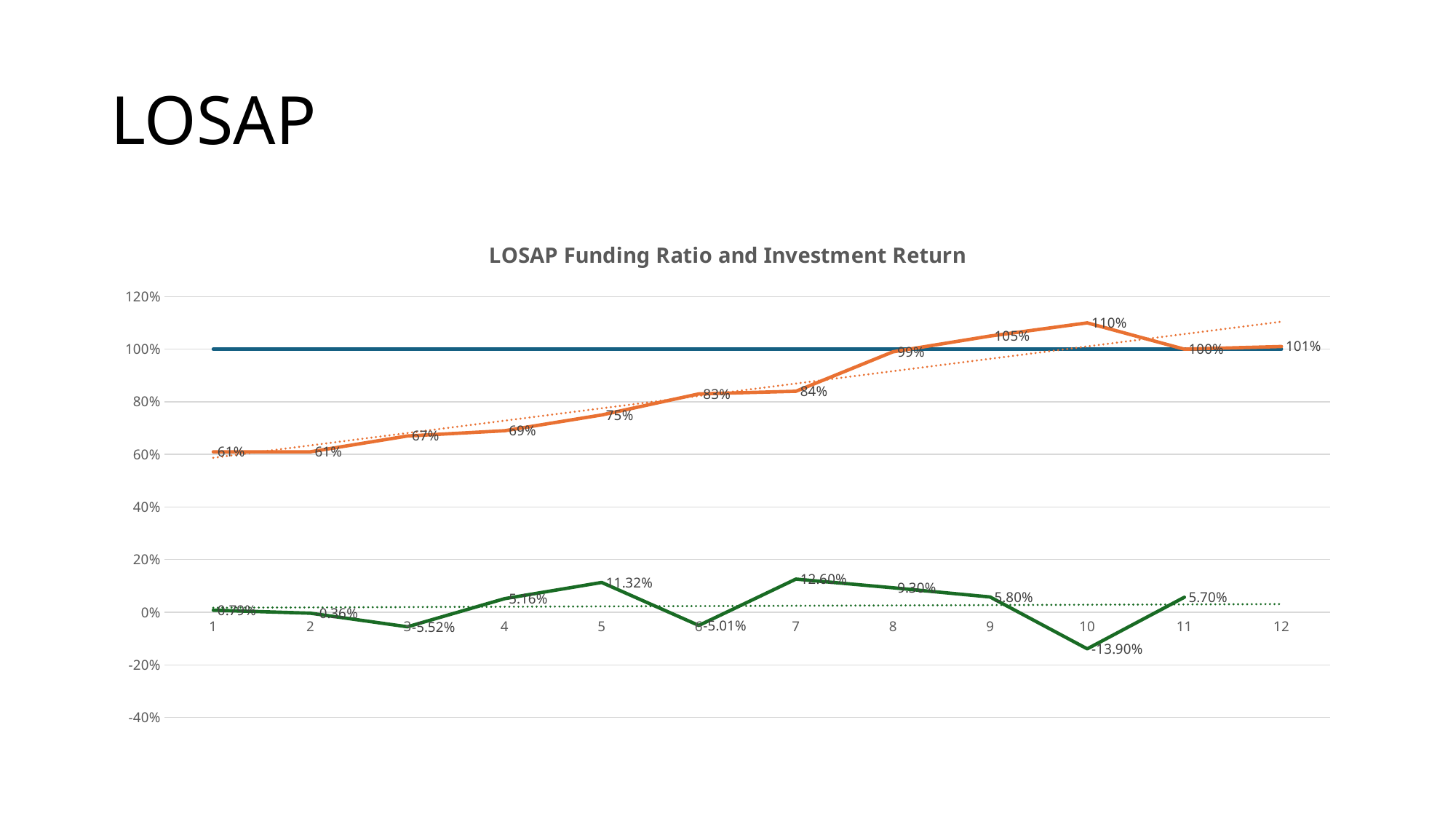
Does the orange line generally rise or fall from x = 1 to x = 10? rise What kind of chart is shown on the slide? line chart Which is larger, the green line's value at x = 5 or at x = 11? x = 5 At which x value does the orange line reach its highest point? 10 What is the difference between the orange line's values at x = 12 and x = 1? 40% What is the value of the green line at x = 10? -13.90% Is the orange line's value at x = 8 greater or less than 100%? less What is the value of the orange line at x = 10? 110% What is the title of the chart? LOSAP Funding Ratio and Investment Return What is the value of the orange line at x = 5? 75% At which x value does the green line reach its lowest point? 10 What is the value of the green line at x = 7? 12.60%